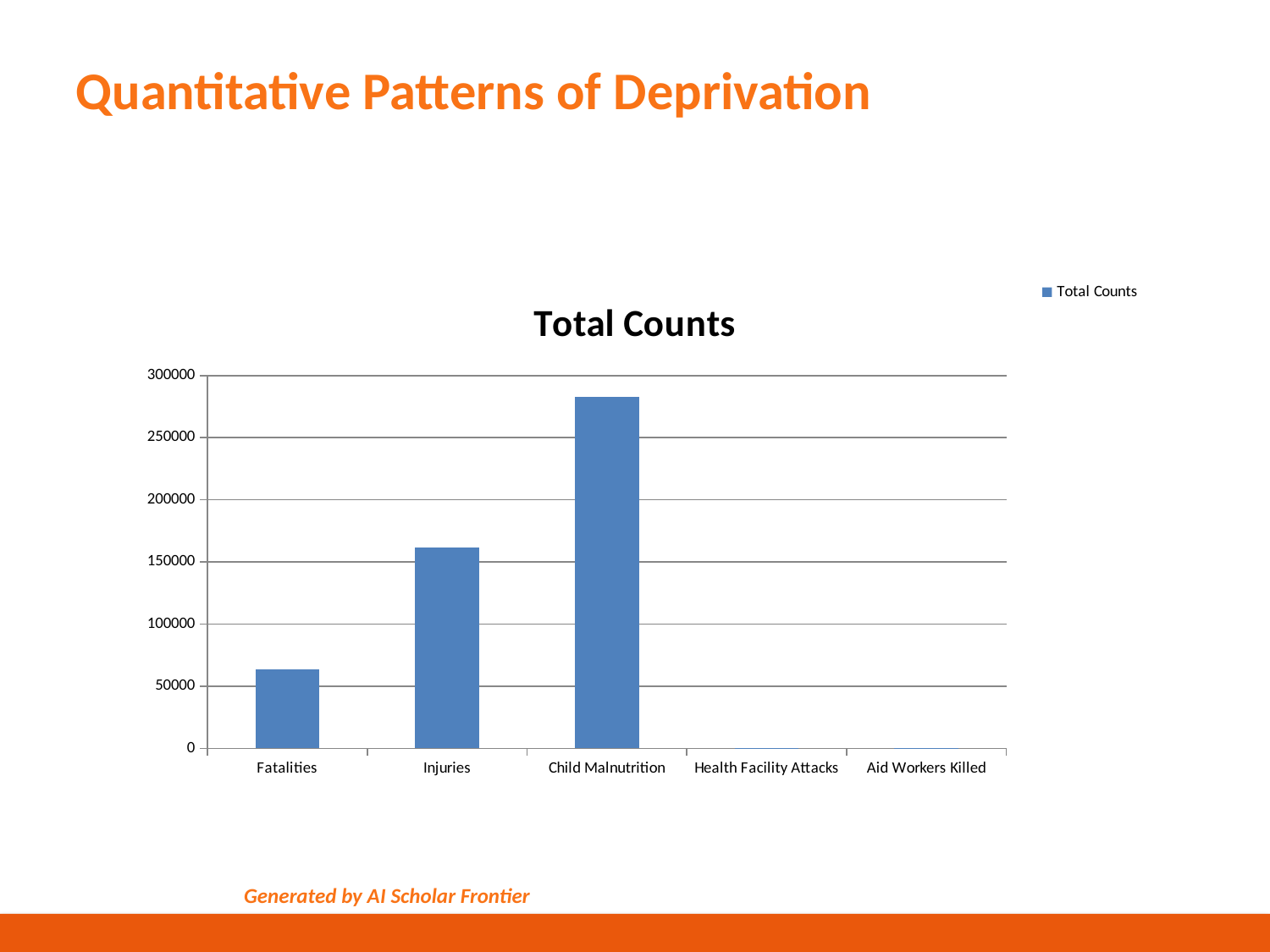
Which category has the highest value in the chart? Child Malnutrition Which is larger, the value for Injuries or the value for Fatalities? Injuries What is the title of the chart? Total Counts Which is larger, the value for Child Malnutrition or the value for Injuries? Child Malnutrition How many series does the legend list? 1 Is the value for Injuries greater or less than 200000? less Is the value for Fatalities greater or less than 100000? less What kind of chart is shown on the slide? bar chart How many categories are shown on the x axis of the chart? 5 Is the value for Health Facility Attacks greater or less than 50000? less What series name is shown in the chart legend? Total Counts